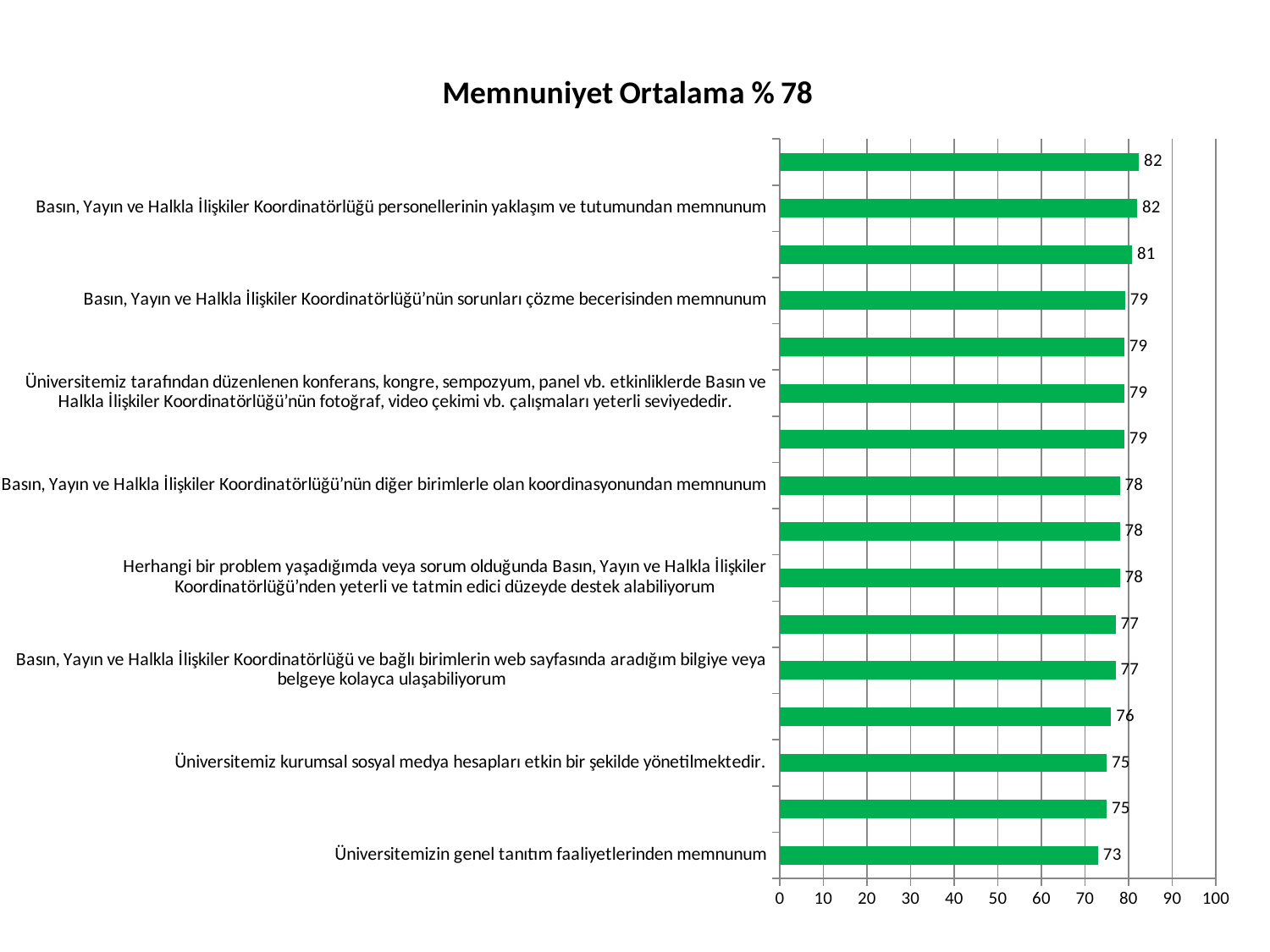
What is the highest value shown on the chart? 82 Is the value for "Üniversitemizin genel tanıtım faaliyetlerinden memnunum" greater or less than 80? less What is the difference between the value for "Basın, Yayın ve Halkla İlişkiler Koordinatörlüğü personellerinin yaklaşım ve tutumundan memnunum" and the value for "Üniversitemizin genel tanıtım faaliyetlerinden memnunum"? 9 Which labelled category has the lowest value? Üniversitemizin genel tanıtım faaliyetlerinden memnunum What is the value for "Basın, Yayın ve Halkla İlişkiler Koordinatörlüğü'nün diğer birimlerle olan koordinasyonundan memnunum"? 78 What is the title of the chart? Memnuniyet Ortalama % 78 What is the value for "Basın, Yayın ve Halkla İlişkiler Koordinatörlüğü'nün sorunları çözme becerisinden memnunum"? 79 Which is larger: the value for "Üniversitemiz kurumsal sosyal medya hesapları etkin bir şekilde yönetilmektedir." or the value for "Basın, Yayın ve Halkla İlişkiler Koordinatörlüğü'nün sorunları çözme becerisinden memnunum"? Basın, Yayın ve Halkla İlişkiler Koordinatörlüğü'nün sorunları çözme becerisinden memnunum What is the value for "Üniversitemizin genel tanıtım faaliyetlerinden memnunum"? 73 What is the value for "Üniversitemiz kurumsal sosyal medya hesapları etkin bir şekilde yönetilmektedir."? 75 How many bars are plotted on the chart? 16 What is the value for "Basın, Yayın ve Halkla İlişkiler Koordinatörlüğü personellerinin yaklaşım ve tutumundan memnunum"? 82